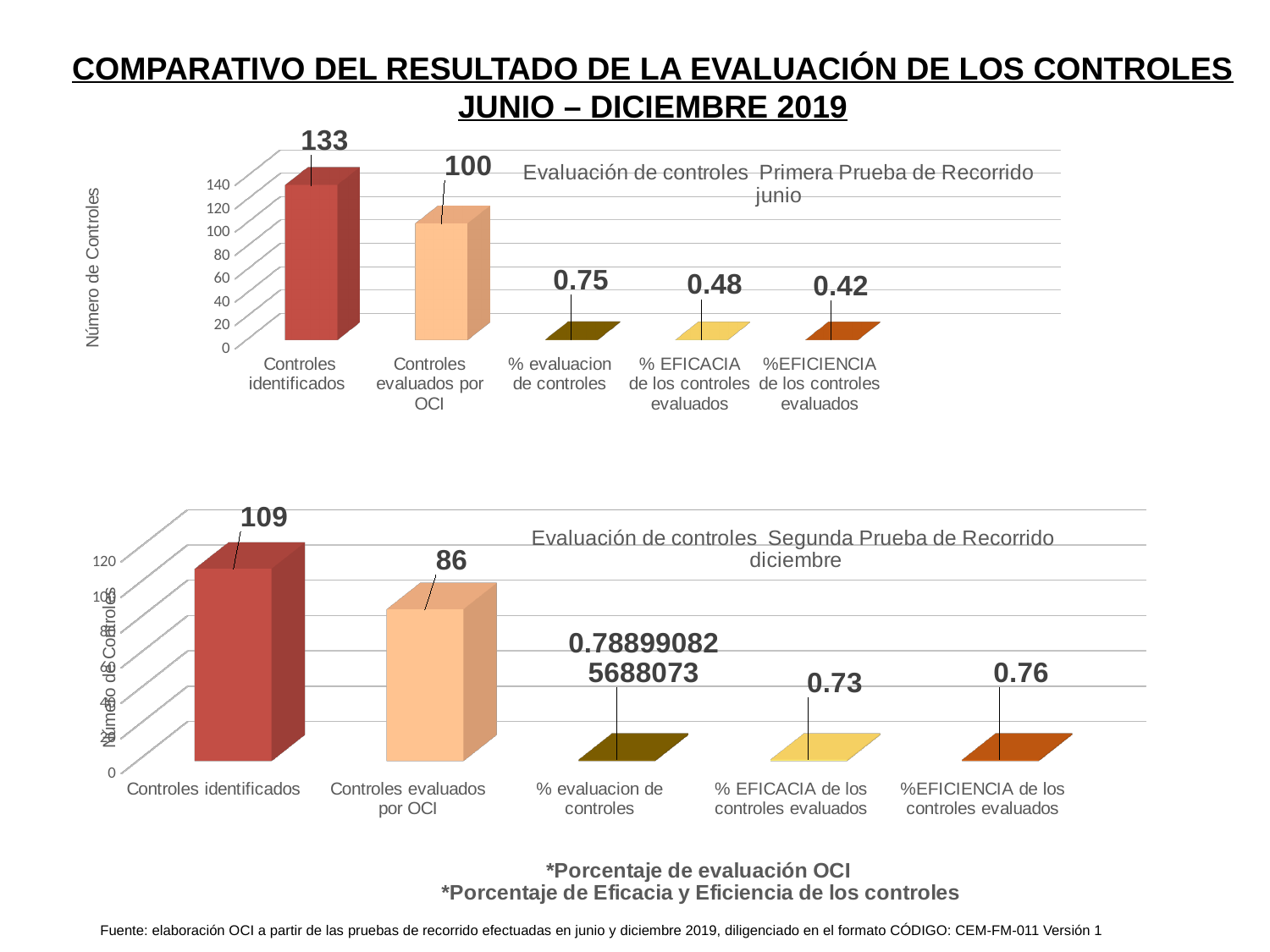
In the bottom chart (Segunda Prueba de Recorrido diciembre), what is the difference between Controles identificados and Controles evaluados por OCI? 23 In the bottom chart (Segunda Prueba de Recorrido diciembre), what is the value for Controles identificados? 109 In the top chart (Primera Prueba de Recorrido junio), what is the value for Controles identificados? 133 What type of chart is the bottom chart (Segunda Prueba de Recorrido diciembre)? Bar chart In the bottom chart (Segunda Prueba de Recorrido diciembre), which is larger: % EFICACIA de los controles evaluados or %EFICIENCIA de los controles evaluados? %EFICIENCIA de los controles evaluados In the top chart (Primera Prueba de Recorrido junio), what is the value for % EFICACIA de los controles evaluados? 0.48 In the top chart (Primera Prueba de Recorrido junio), what is the value for Controles evaluados por OCI? 100 In the bottom chart (Segunda Prueba de Recorrido diciembre), what is the value for Controles evaluados por OCI? 86 In the top chart (Primera Prueba de Recorrido junio), what is the difference between Controles identificados and Controles evaluados por OCI? 33 How many categories are shown in the top chart (Primera Prueba de Recorrido junio)? 5 In the bottom chart (Segunda Prueba de Recorrido diciembre), what is the value for %EFICIENCIA de los controles evaluados? 0.76 In the top chart (Primera Prueba de Recorrido junio), which category has the lowest value? %EFICIENCIA de los controles evaluados